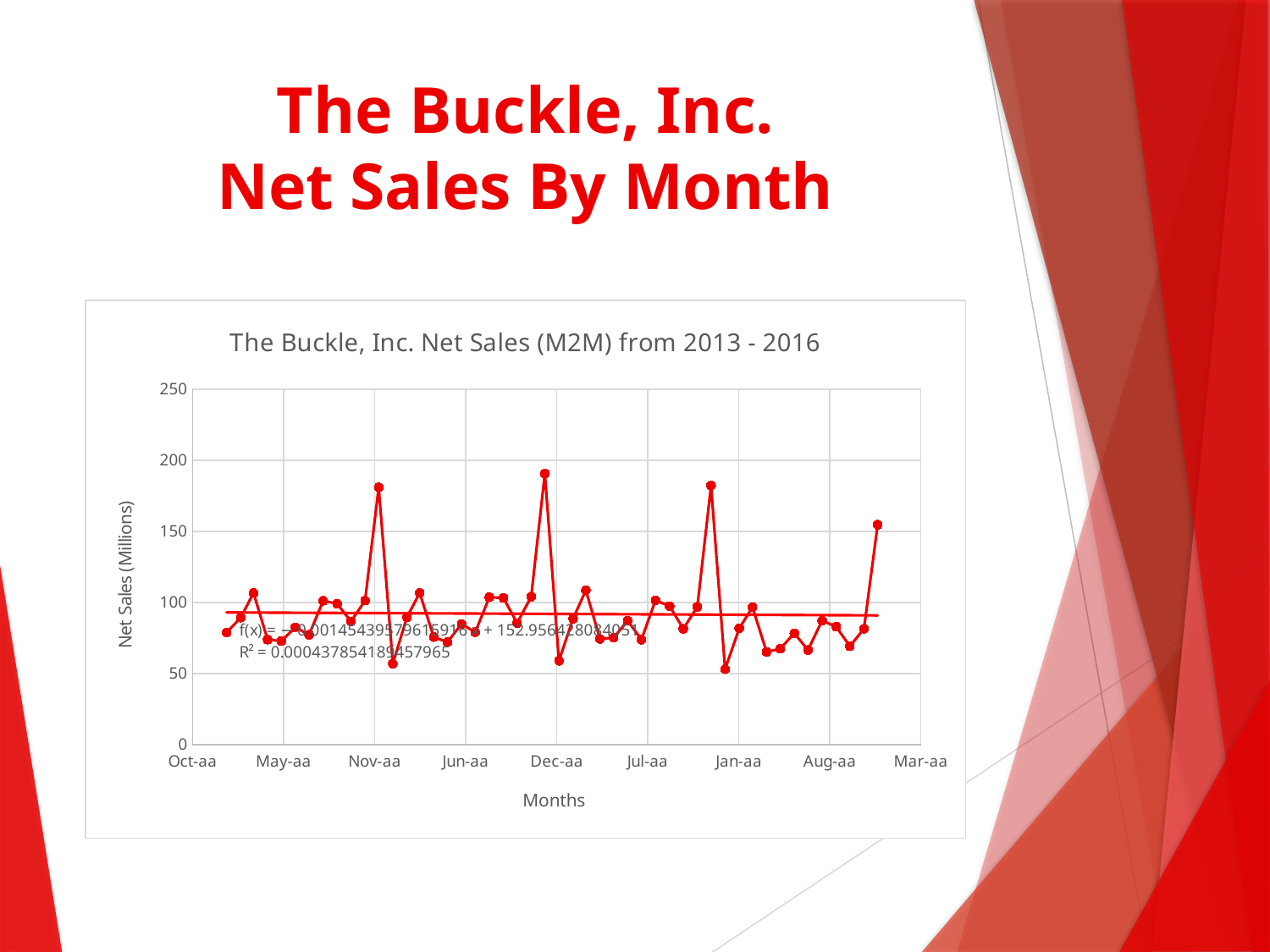
Which is larger, the first plotted point or the last plotted point on the chart? the last plotted point Is the lowest plotted value on the chart greater or less than 100? less What type of chart is shown on the slide? line chart Is the highest plotted value on the chart greater or less than 150? greater Is the first plotted point on the chart greater or less than 100? less What is the label on the vertical axis of the chart? Net Sales (Millions) What is the title of the chart? The Buckle, Inc. Net Sales (M2M) from 2013 - 2016 What R² value is printed on the chart? 0.000437854189457965 How many plotted points on the chart rise above the 150 gridline? 4